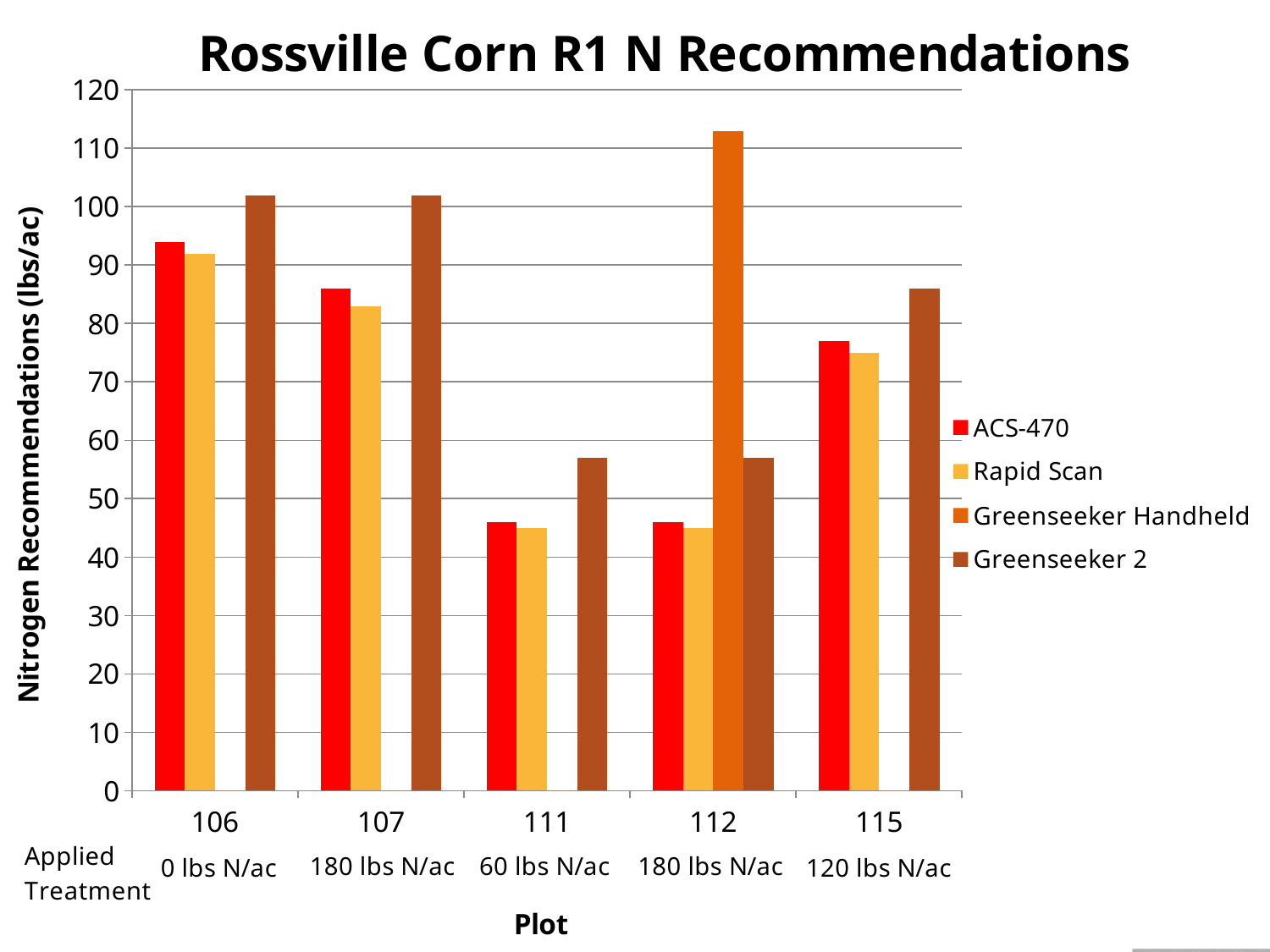
For which plot is the Rapid Scan recommendation highest? 106 What applied treatment is listed under plot 112? 180 lbs N/ac Which series and plot has the tallest bar in the chart? Greenseeker Handheld, plot 112 What kind of chart is shown on the slide? bar chart Is the Greenseeker Handheld value for plot 112 greater or less than 100? greater How many plots are shown on the x axis? 5 Which is larger: the ACS-470 value for plot 107 or for plot 115? plot 107 Is the Rapid Scan value for plot 115 greater or less than 70? greater Is the Greenseeker 2 value for plot 111 greater or less than 60? less For which plot is the ACS-470 recommendation highest? 106 How many series does the legend list? 4